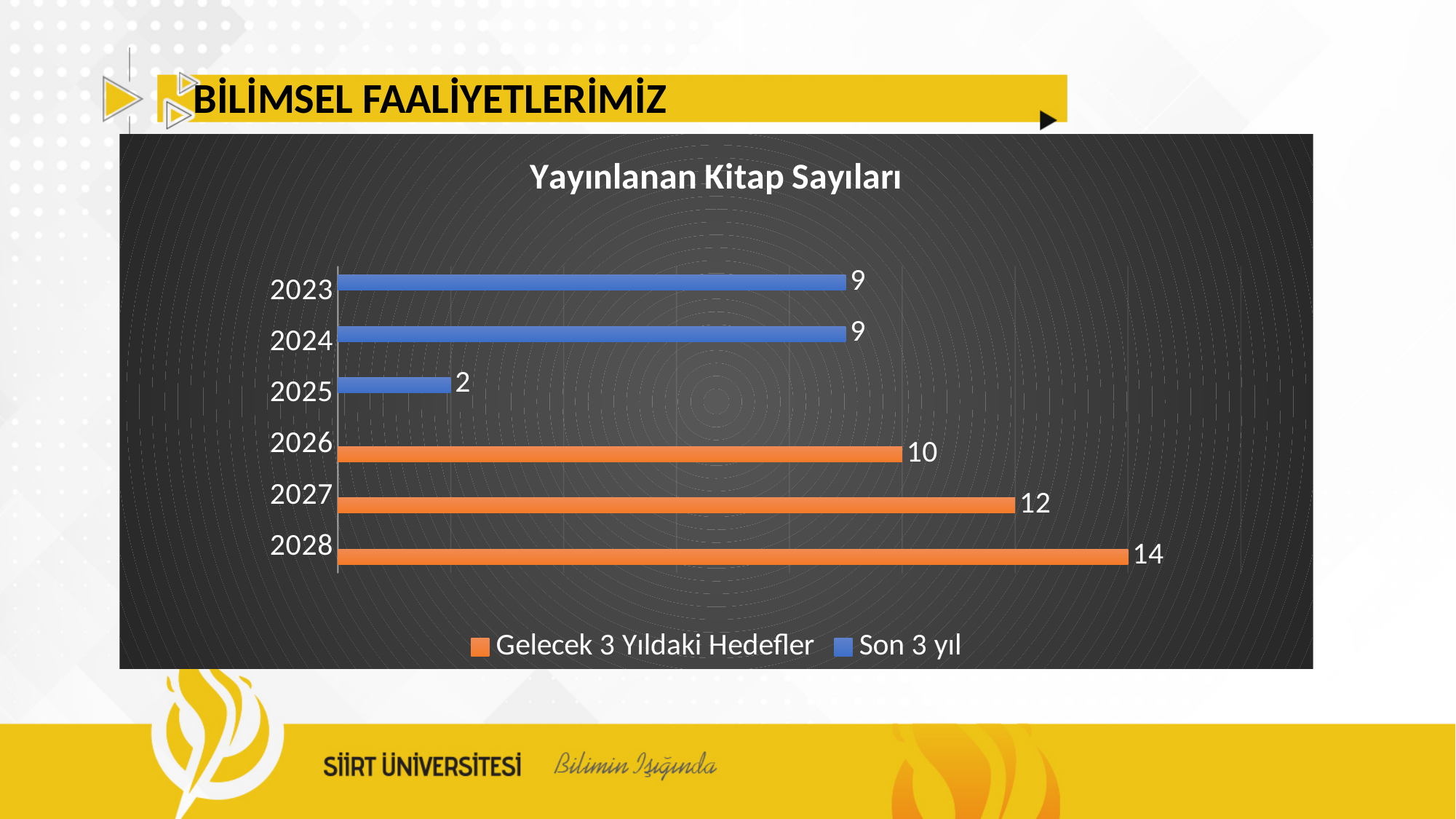
What kind of chart is shown on the slide? Bar chart Which year has the lowest value in the chart? 2025 Which year has the highest value in the chart? 2028 How many series does the legend list? 2 Which is larger, the value for 2024 or the value for 2026? 2026 What is the value for 2023 in the chart? 9 What is the difference between the values for 2028 and 2026? 4 What is the value for 2028 in the chart? 14 What is the value for 2027 in the chart? 12 What is the title of the chart? Yayınlanan Kitap Sayıları What is the value for 2025 in the chart? 2 How many years are shown on the chart? 6